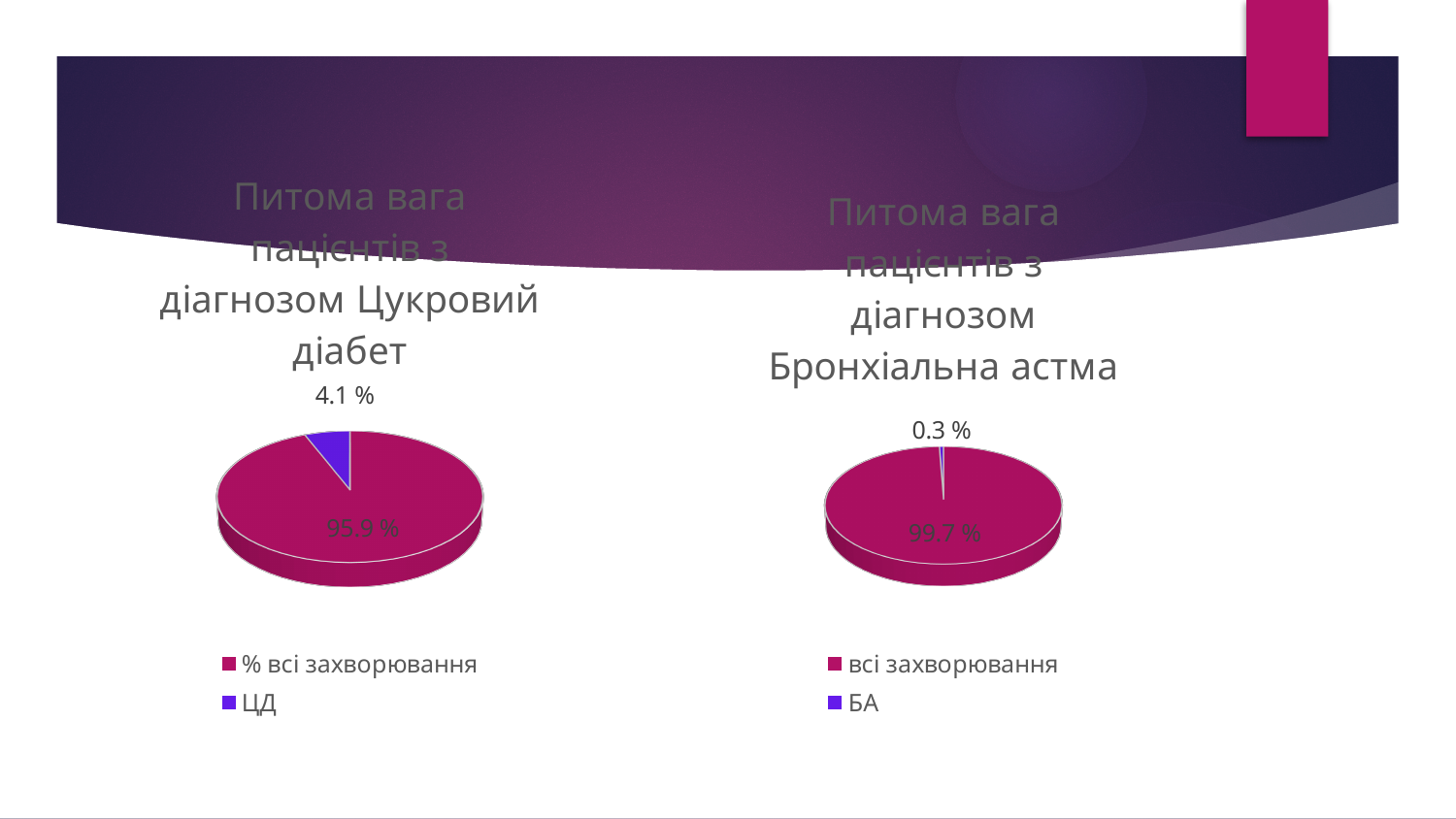
In the left pie chart (Цукровий діабет), which slice is the largest? % всі захворювання How many slices does the right pie chart (Бронхіальна астма) have? 2 In the left pie chart (Цукровий діабет), what is the value of the ЦД slice? 4.1 % In the right pie chart (Бронхіальна астма), which slice is the smallest? БА How many entries does the legend of the left pie chart (Цукровий діабет) list? 2 In the right pie chart (Бронхіальна астма), what is the value of the БА slice? 0.3 % Which is larger: the ЦД slice in the left chart or the БА slice in the right chart? ЦД In the right pie chart (Бронхіальна астма), what is the value of the 'всі захворювання' slice? 99.7 % In the left pie chart (Цукровий діабет), what is the difference between the '% всі захворювання' slice and the ЦД slice? 91.8 % In the left pie chart (Цукровий діабет), what is the value of the '% всі захворювання' slice? 95.9 % What is the title of the right chart on the slide? Питома вага пацієнтів з діагнозом Бронхіальна астма What kind of chart is the left chart on the slide? pie chart